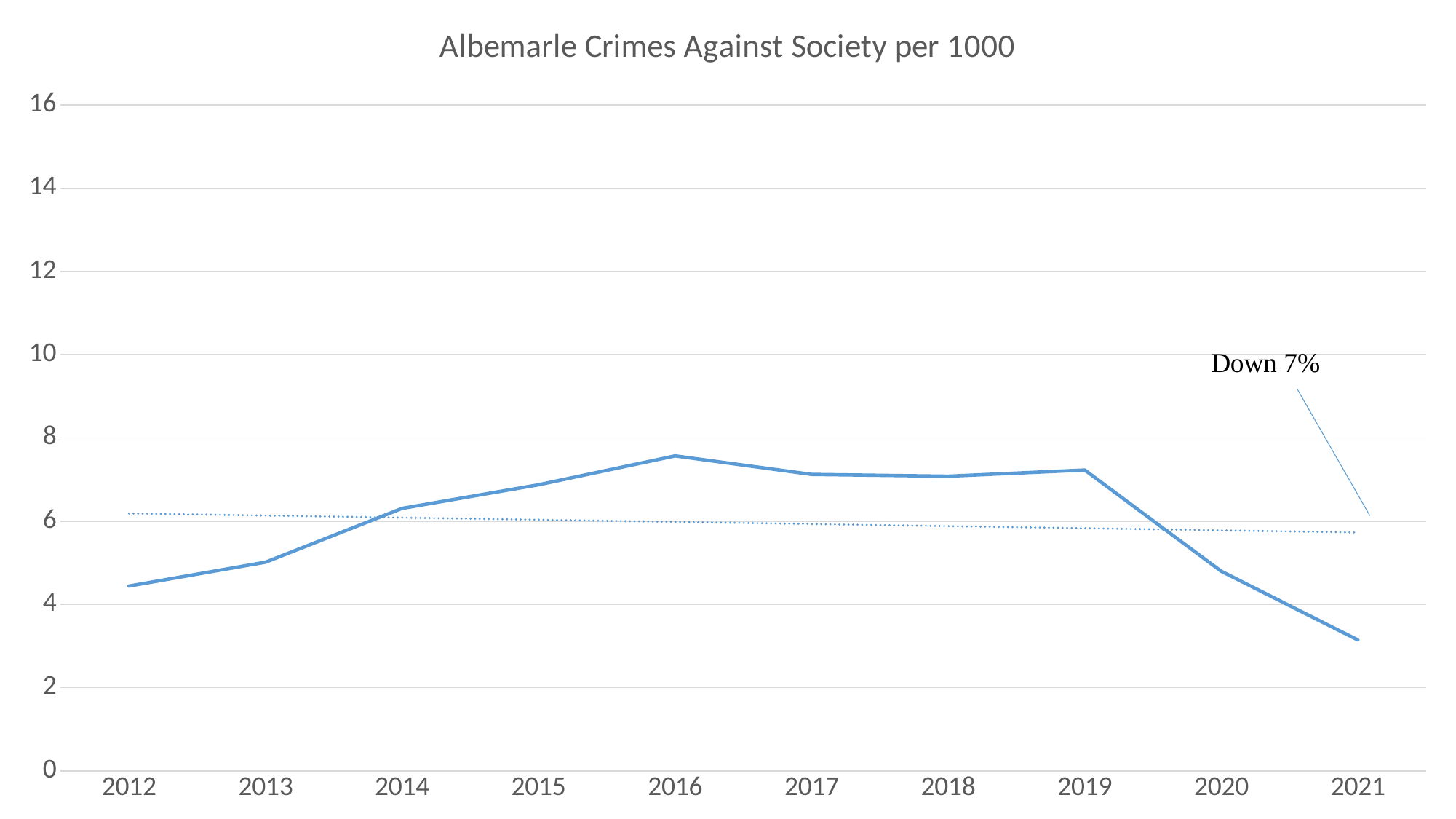
Is the value for 2014 greater or less than 6? greater What does the annotation near the end of the line say? Down 7% Is the value for 2021 greater or less than 4? less Which year has the larger value, 2012 or 2016? 2016 What kind of chart is shown on the slide? line chart In which year is the crimes against society rate highest? 2016 Which year has the larger value, 2019 or 2020? 2019 Is the value for 2020 greater or less than 6? less What is the title of the chart? Albemarle Crimes Against Society per 1000 In which year is the crimes against society rate lowest? 2021 How many years are plotted along the x axis? 10